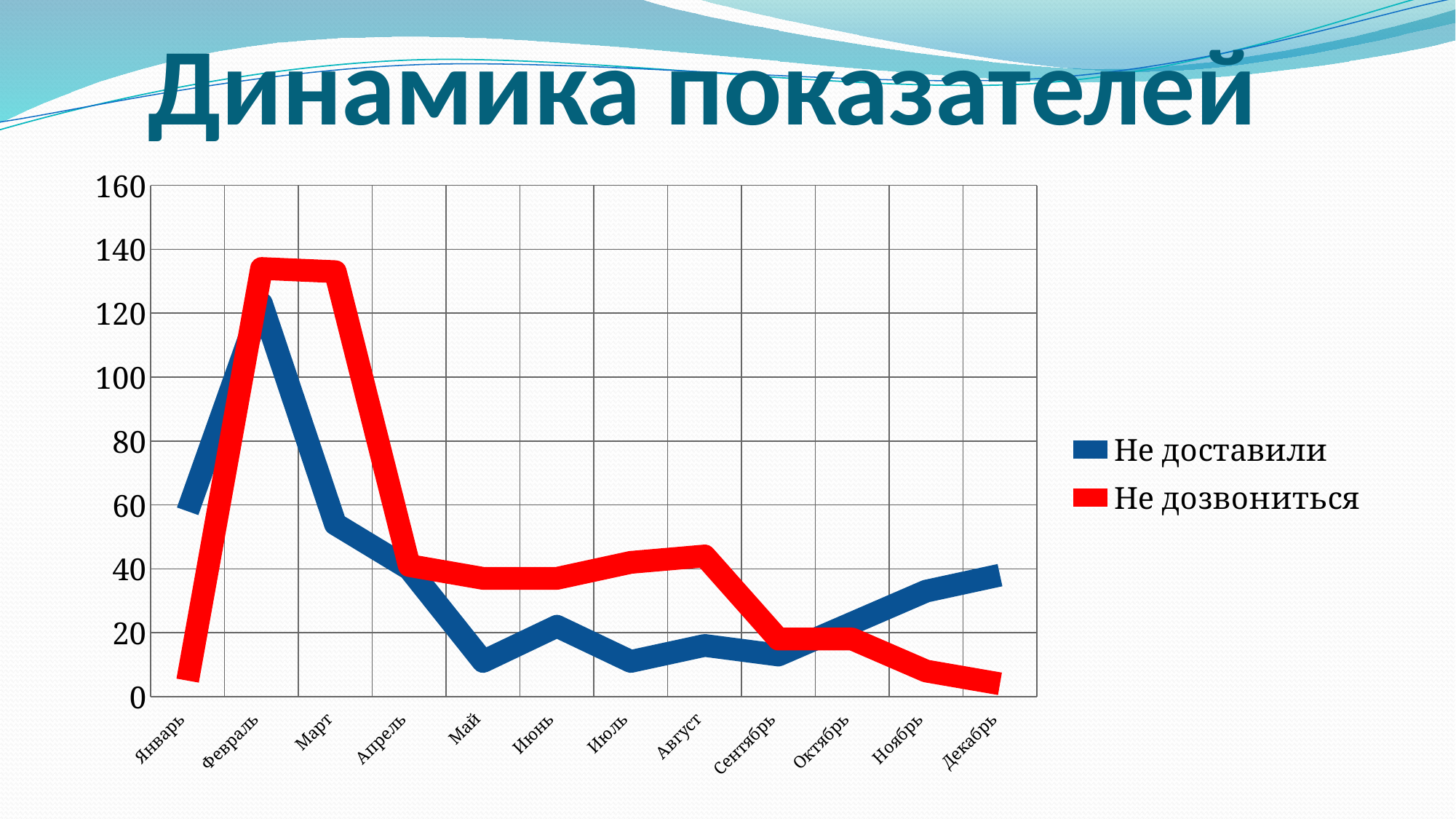
What kind of chart is shown on the slide? line chart Is the value for "Не доставили" in Май greater or less than 20? less How many series does the legend list? 2 How many months are plotted along the x axis? 12 Is the value for "Не доставили" in Февраль greater or less than 100? greater In Март, which series has the higher value, "Не доставили" or "Не дозвониться"? Не дозвониться Is the value for "Не дозвониться" in Январь greater or less than 20? less In which month does the "Не доставили" series reach its highest value? Февраль What is the title of the slide? Динамика показателей Which colour represents the series "Не дозвониться"? red In Декабрь, which series has the higher value, "Не доставили" or "Не дозвониться"? Не доставили